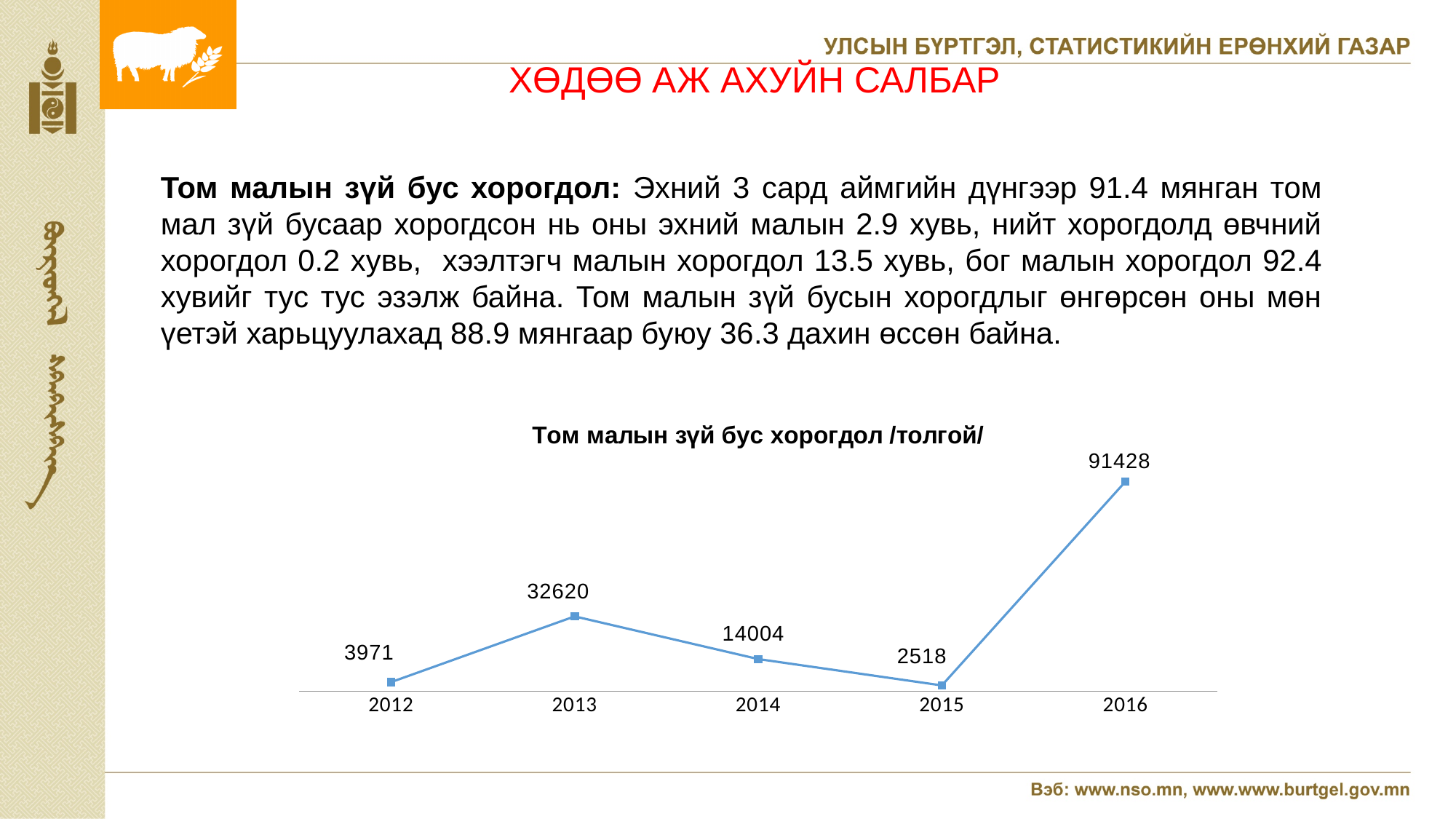
What is the value for 2016 in the chart? 91428 What is the value for 2013 in the chart? 32620 Which year has the lowest value in the chart? 2015 How many years are plotted in the chart? 5 Which is larger, the value for 2013 or the value for 2014? 2013 What is the difference between the values for 2016 and 2015? 88910 What is the value for 2012 in the chart? 3971 What is the title of the chart? Том малын зүй бус хорогдол /толгой/ What is the value for 2015 in the chart? 2518 What is the difference between the values for 2013 and 2014? 18616 Which year has the highest value in the chart? 2016 What kind of chart is shown on the slide? line chart